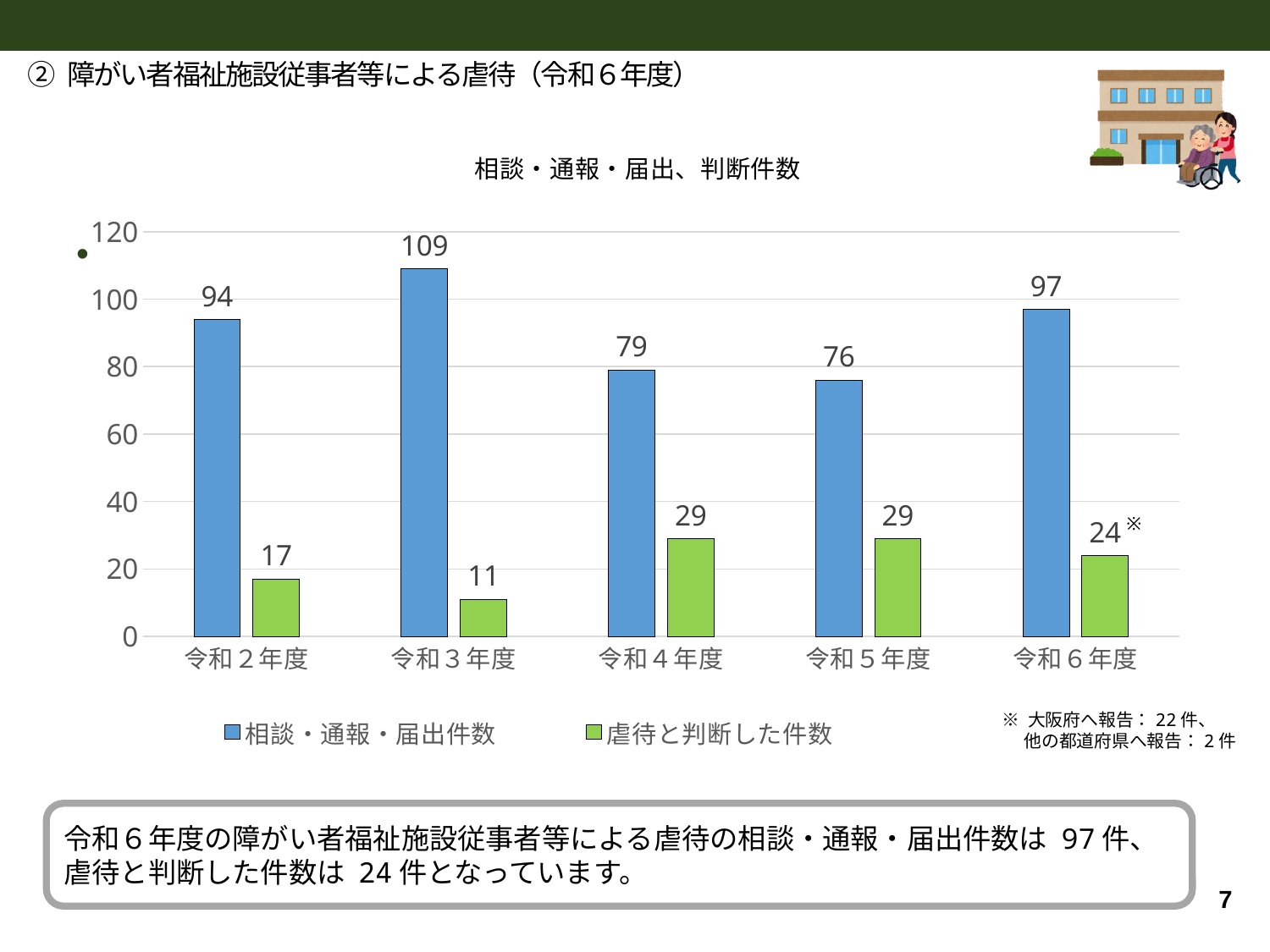
Which is larger, the 相談・通報・届出件数 for 令和４年度 or for 令和５年度? 令和４年度 How many fiscal years are shown on the x axis? 5 Which year has the highest 相談・通報・届出件数? 令和３年度 What is the difference between the 相談・通報・届出件数 and the 虐待と判断した件数 in 令和６年度? 73 How many series does the legend list? 2 What kind of chart is shown on the slide? bar chart What is the title of the chart? 相談・通報・届出、判断件数 What is the 虐待と判断した件数 value for 令和２年度? 17 Is the 相談・通報・届出件数 for 令和２年度 greater or less than 80? greater What is the 相談・通報・届出件数 value for 令和３年度? 109 What is the 虐待と判断した件数 value for 令和６年度? 24 Which year has the lowest 虐待と判断した件数? 令和３年度